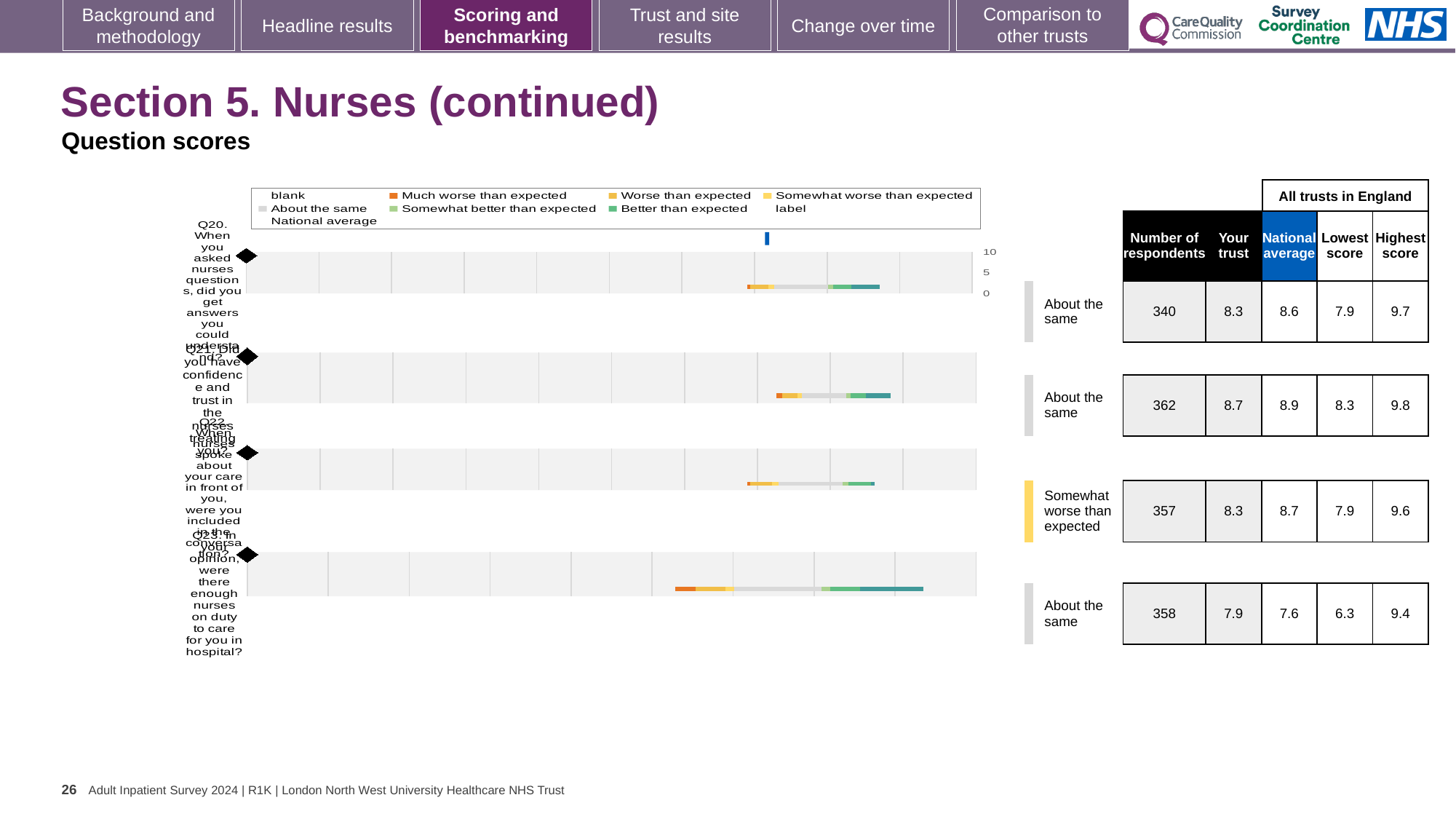
What is the 'Your trust' score for Q21 (confidence and trust in the nurses)? 8.7 What is the difference between the highest score and the lowest score across all trusts in England for Q21? 1.5 What benchmark category is shown for Q22 (nurses speaking about your care in front of you)? Somewhat worse than expected What is the national average score for Q23 (enough nurses on duty)? 7.6 How many questions (categories) are plotted in the chart? 4 Which question has the lowest 'Your trust' score? Q23 Which question has the highest 'Your trust' score? Q21 What is the highest score across all trusts in England for Q20? 9.7 By how much does the 'Your trust' score for Q23 exceed the national average? 0.3 What kind of chart is used to show the question scores on this slide? bar chart How many respondents answered Q20? 340 For Q22, which is larger: the 'Your trust' score or the national average? National average